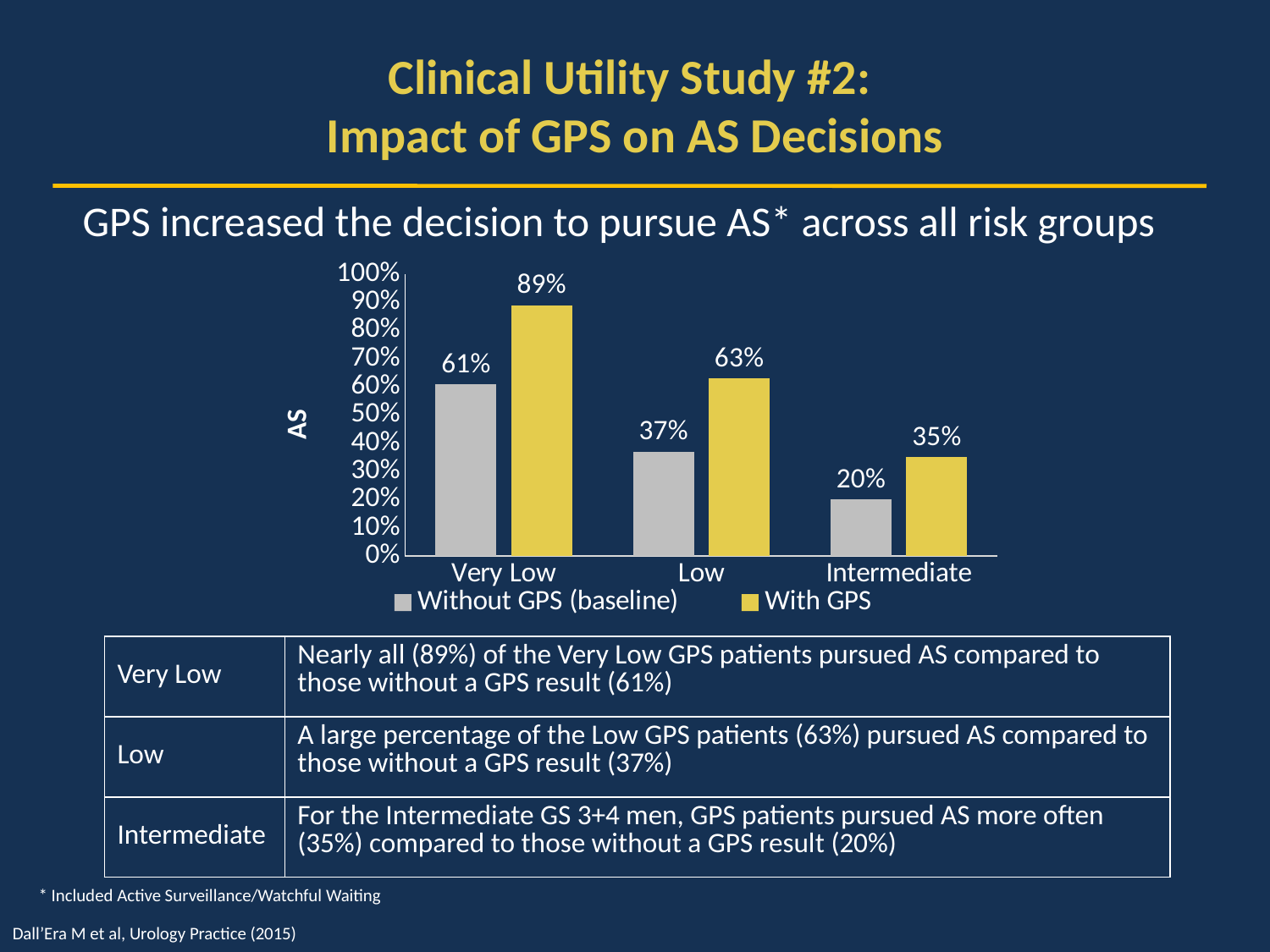
Which risk group has the highest With GPS value? Very Low What is the value for Intermediate in the Without GPS (baseline) series? 20% Which is larger for Intermediate: the With GPS value or the Without GPS (baseline) value? With GPS What kind of chart is shown on the slide? Bar chart What is the label of the y axis? AS Do the With GPS values rise or fall from Very Low to Intermediate? Fall What is the value for Very Low in the With GPS series? 89% What is the difference between the With GPS and Without GPS (baseline) values for Low? 26% Which risk group has the lowest Without GPS (baseline) value? Intermediate How many risk groups are shown on the x axis? 3 What is the value for Low in the With GPS series? 63% How many series does the legend list? 2